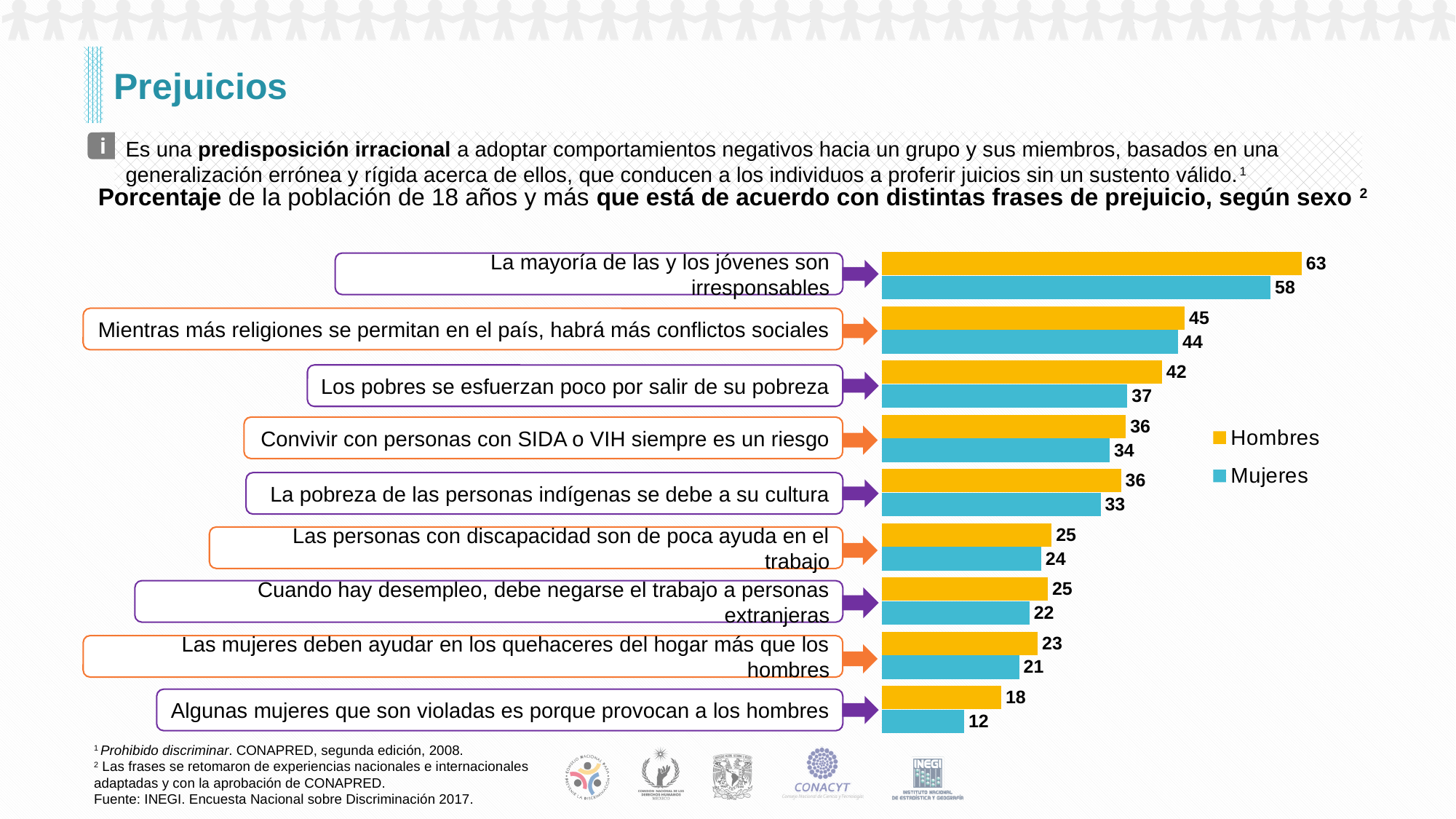
What is the difference between the Hombres and Mujeres values for "Los pobres se esfuerzan poco por salir de su pobreza"? 5 What is the value for Mujeres for "Los pobres se esfuerzan poco por salir de su pobreza"? 37 How many prejudice statements are shown in the chart? 9 Which statement has the highest percentage of agreement among Hombres? La mayoría de las y los jóvenes son irresponsables For "Convivir con personas con SIDA o VIH siempre es un riesgo", which group has the larger value, Hombres or Mujeres? Hombres What is the difference between the Hombres and Mujeres values for "Algunas mujeres que son violadas es porque provocan a los hombres"? 6 What percentage of men (Hombres) agree that most young people are irresponsible ("La mayoría de las y los jóvenes son irresponsables")? 63 How many series does the legend list? 2 Which statement has the lowest percentage of agreement among Mujeres? Algunas mujeres que son violadas es porque provocan a los hombres Which colour represents Mujeres in the chart? Blue What percentage of women (Mujeres) agree with "Algunas mujeres que son violadas es porque provocan a los hombres"? 12 What type of chart is used on this slide? Bar chart